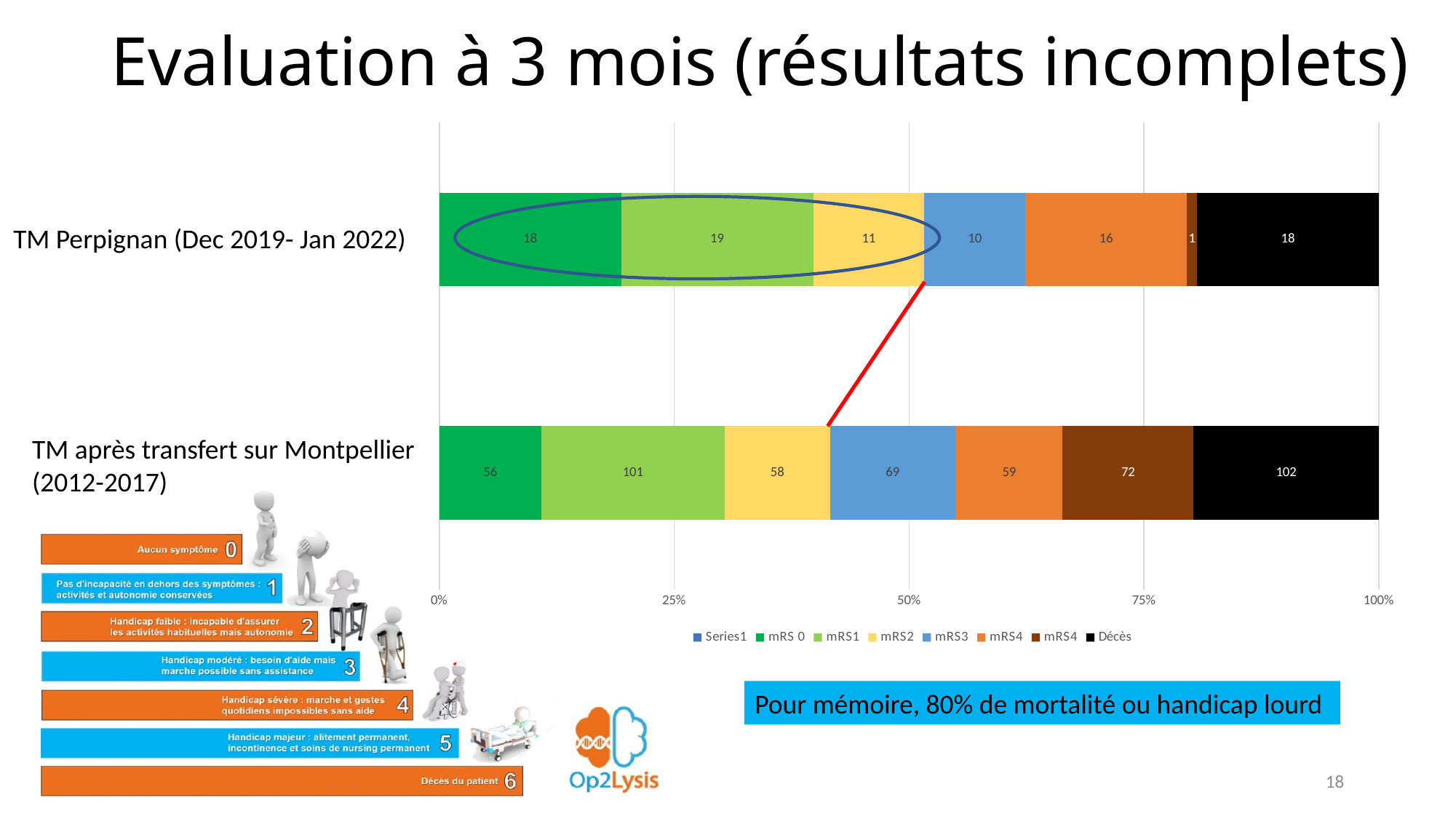
How many bars (categories) does the chart show? 2 What is the total of all labelled values in the TM Perpignan (Dec 2019- Jan 2022) bar? 93 Which segment has the largest value in the TM après transfert sur Montpellier (2012-2017) bar? Décès What is the value of the mRS 0 segment for TM Perpignan (Dec 2019- Jan 2022)? 18 In the TM après transfert sur Montpellier (2012-2017) bar, what is the value of the mRS1 segment? 101 What is the smallest value labelled in the TM Perpignan (Dec 2019- Jan 2022) bar? 1 In the TM Perpignan (Dec 2019- Jan 2022) bar, which is larger: the mRS2 segment or the mRS3 segment? mRS2 How many entries does the chart legend list? 8 In the TM Perpignan (Dec 2019- Jan 2022) bar, what is the value of the Décès segment? 18 What is the difference between the Décès values for TM après transfert sur Montpellier (2012-2017) and TM Perpignan (Dec 2019- Jan 2022)? 84 What kind of chart is shown on the slide? Stacked bar chart What is the value of the mRS3 segment for TM après transfert sur Montpellier (2012-2017)? 69